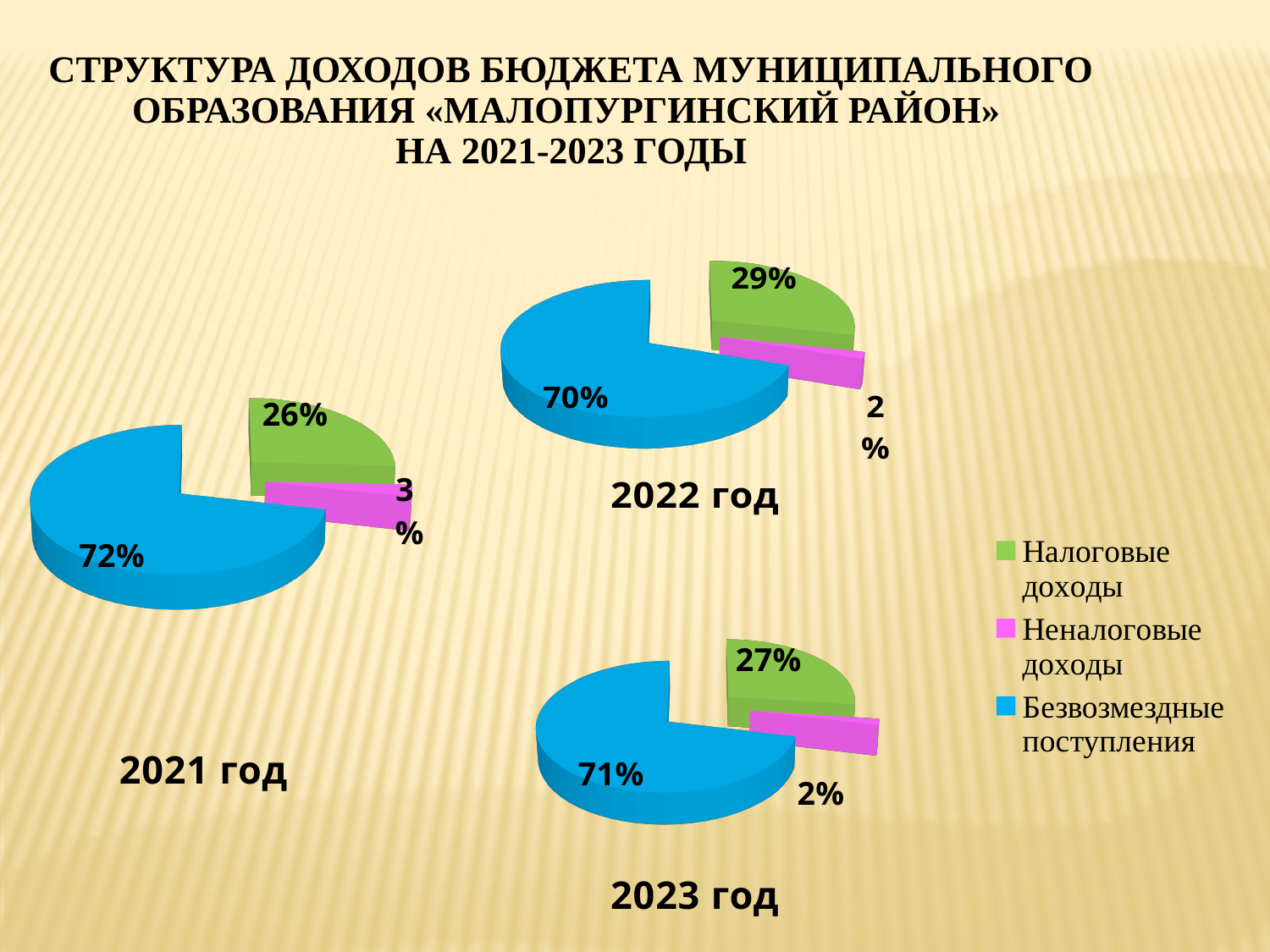
What type of chart is used for 2023 год? Pie chart Which colour represents Неналоговые доходы in the legend? Pink (magenta) How many slices does the 2021 год pie chart have? 3 In the 2022 год pie chart, which category has the smallest slice? Неналоговые доходы In the 2022 год pie chart, what share is shown for Безвозмездные поступления? 70% In the 2021 год pie chart, what share is shown for Налоговые доходы? 26% In the 2021 год pie chart, which category has the largest slice? Безвозмездные поступления How many entries does the legend list? 3 Is the share of Налоговые доходы larger in the 2022 год pie chart or in the 2021 год pie chart? 2022 год How many pie charts are on the slide? 3 In the 2023 год pie chart, what is the difference between the shares of Безвозмездные поступления and Налоговые доходы? 44% In the 2023 год pie chart, what share is shown for Неналоговые доходы? 2%